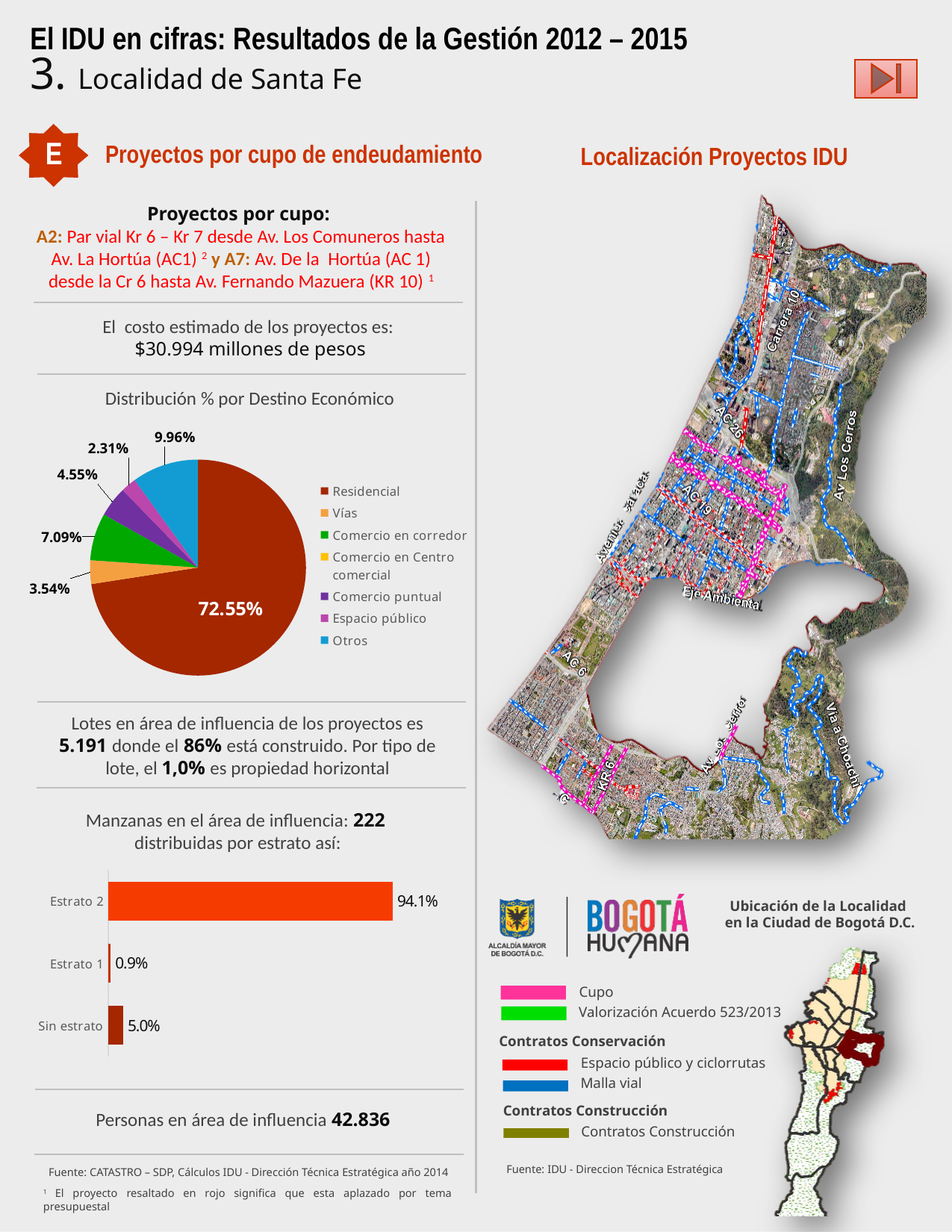
In the bar chart 'Manzanas en el área de influencia', which category has the lowest value? Estrato 1 In the pie chart 'Distribución % por Destino Económico', what share does Residencial have? 72.55% In the bar chart 'Manzanas en el área de influencia', what is the value for Sin estrato? 5.0% In the pie chart 'Distribución % por Destino Económico', what is the difference between Otros and Comercio en corredor? 2.87% In the pie chart 'Distribución % por Destino Económico', what is the value for Vías? 3.54% What type of chart is used for 'Manzanas en el área de influencia' distributed by estrato? Bar chart In the pie chart 'Distribución % por Destino Económico', what is the value for Comercio en corredor? 7.09% In the pie chart 'Distribución % por Destino Económico', which is larger: Comercio puntual or Espacio público? Comercio puntual In the pie chart 'Distribución % por Destino Económico', which category has the largest slice? Residencial In the pie chart 'Distribución % por Destino Económico', what is the value for Otros? 9.96% In the bar chart 'Manzanas en el área de influencia', what is the value for Estrato 2? 94.1% In the pie chart 'Distribución % por Destino Económico', how many entries does the legend list? 7